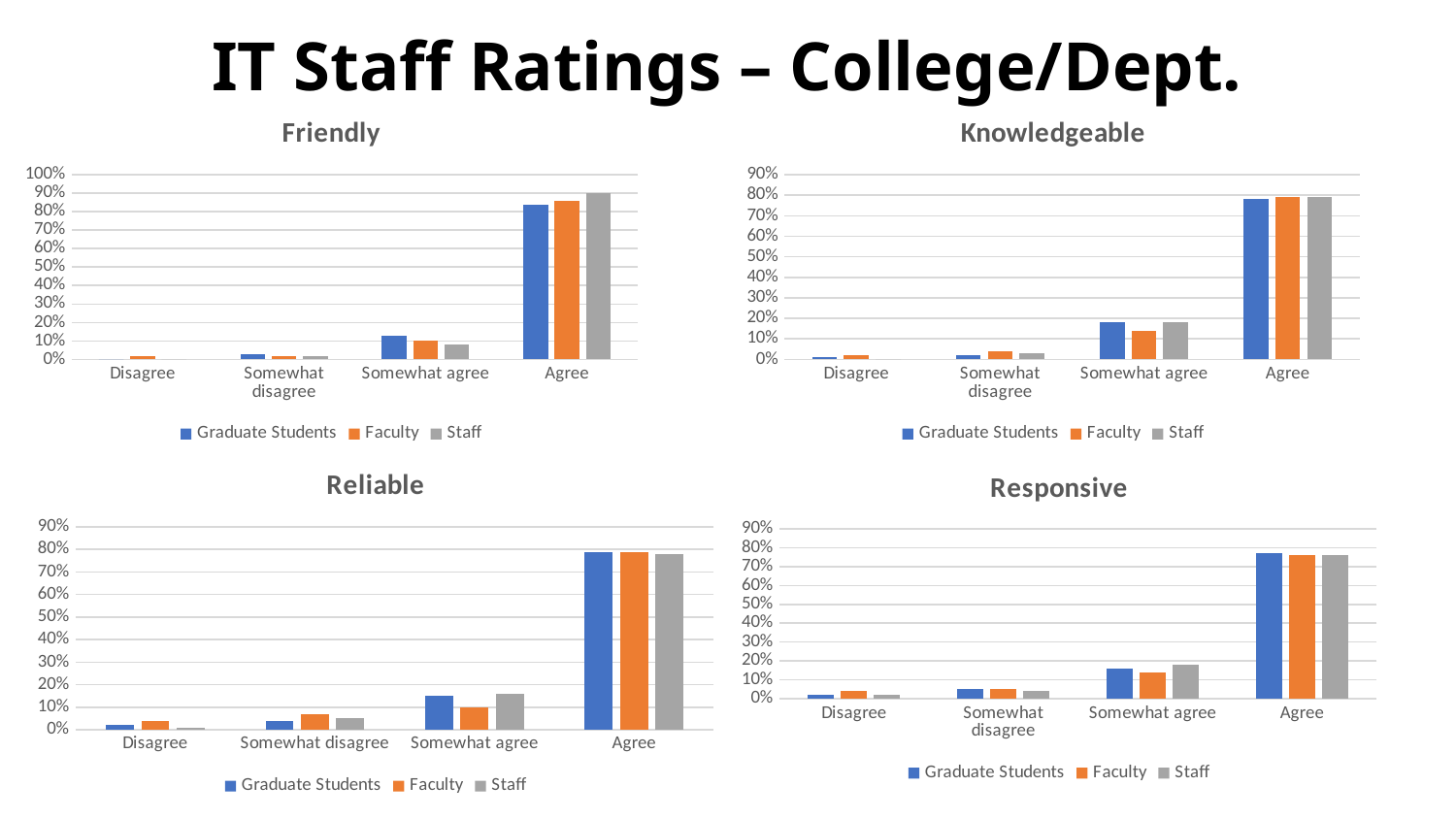
What is the title of the chart in the bottom-right of the slide? Responsive In the Friendly chart, is the value for Staff in the Agree category greater or less than 80%? greater How many categories are shown on the x axis of the Reliable chart? 4 In the Reliable chart, is the value for Faculty in the Somewhat agree category larger or smaller than the value for Staff in the same category? smaller In the Knowledgeable chart, is the value for Graduate Students in the Agree category greater or less than 70%? greater How many series does the legend of the Knowledgeable chart list? 3 In the Responsive chart, do the values for Graduate Students rise or fall from Disagree to Agree along the x axis? rise In the Responsive chart, which series has the highest value in the Somewhat agree category? Staff In the Knowledgeable chart, which series has the lowest value in the Somewhat agree category? Faculty What kind of chart is the Friendly chart? bar chart In the Reliable chart, which series has the lowest value in the Somewhat agree category? Faculty In the Friendly chart, is the value for Graduate Students in the Somewhat agree category greater or less than 10%? greater